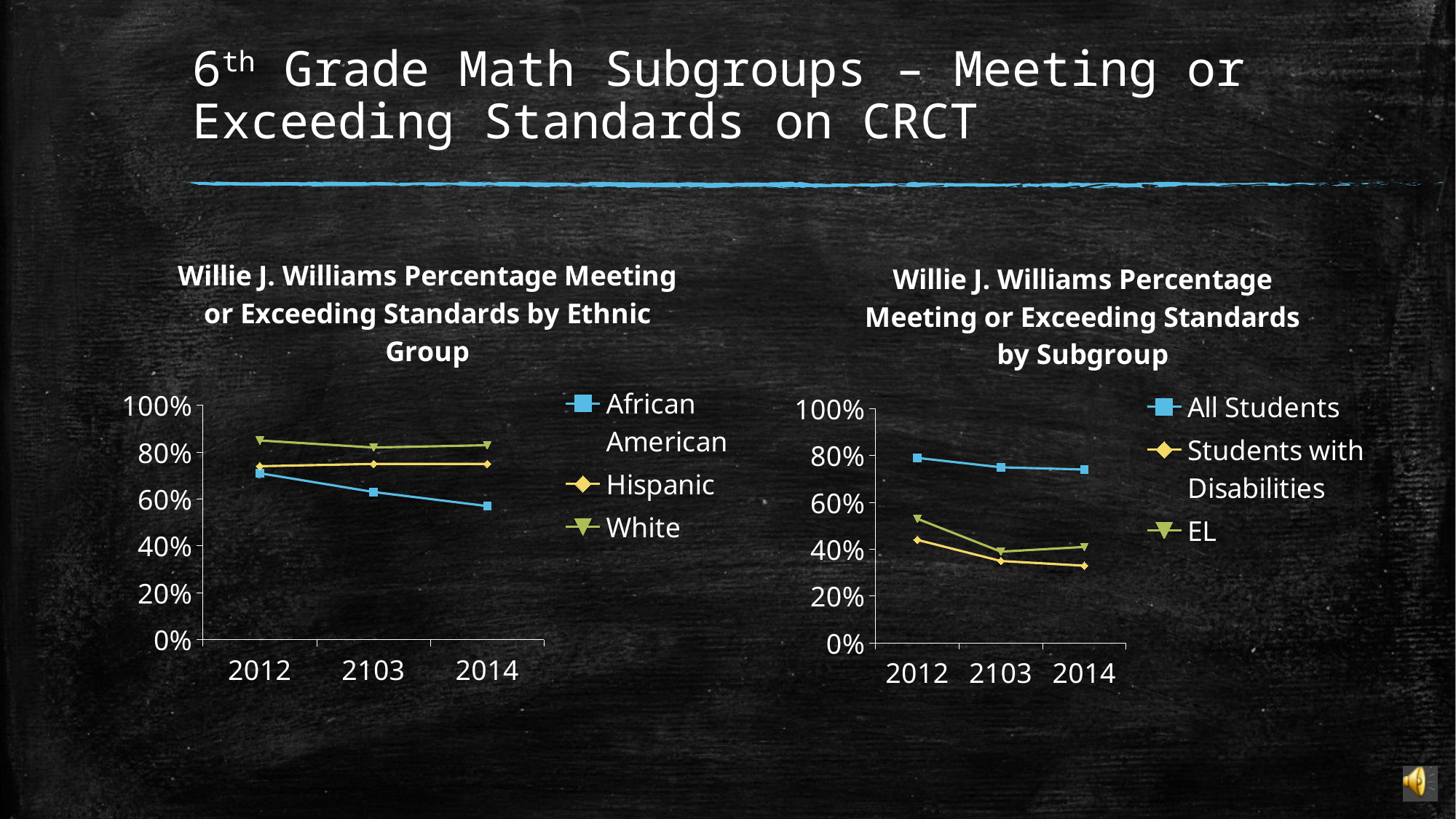
In the left chart (by Ethnic Group), which series has the lowest value in 2014? African American In the left chart (by Ethnic Group), is the value for African American in 2014 greater or less than 60%? less In the right chart (by Subgroup), is the value for Students with Disabilities in 2014 greater or less than 40%? less In the right chart (by Subgroup), does the All Students series rise or fall from 2012 to 2014? Fall In the right chart (by Subgroup), which is larger in 2012: EL or Students with Disabilities? EL In the right chart (by Subgroup), which series has the highest value in 2014? All Students How many series does the legend of the right chart (by Subgroup) list? 3 How many series does the legend of the left chart (by Ethnic Group) list? 3 In the left chart (by Ethnic Group), which series has the highest value in 2012? White In the left chart (by Ethnic Group), does the African American series rise or fall from 2012 to 2014? Fall What kind of chart is the left chart, 'Willie J. Williams Percentage Meeting or Exceeding Standards by Ethnic Group'? Line chart How many points along the x axis does the left chart (by Ethnic Group) show for each series? 3